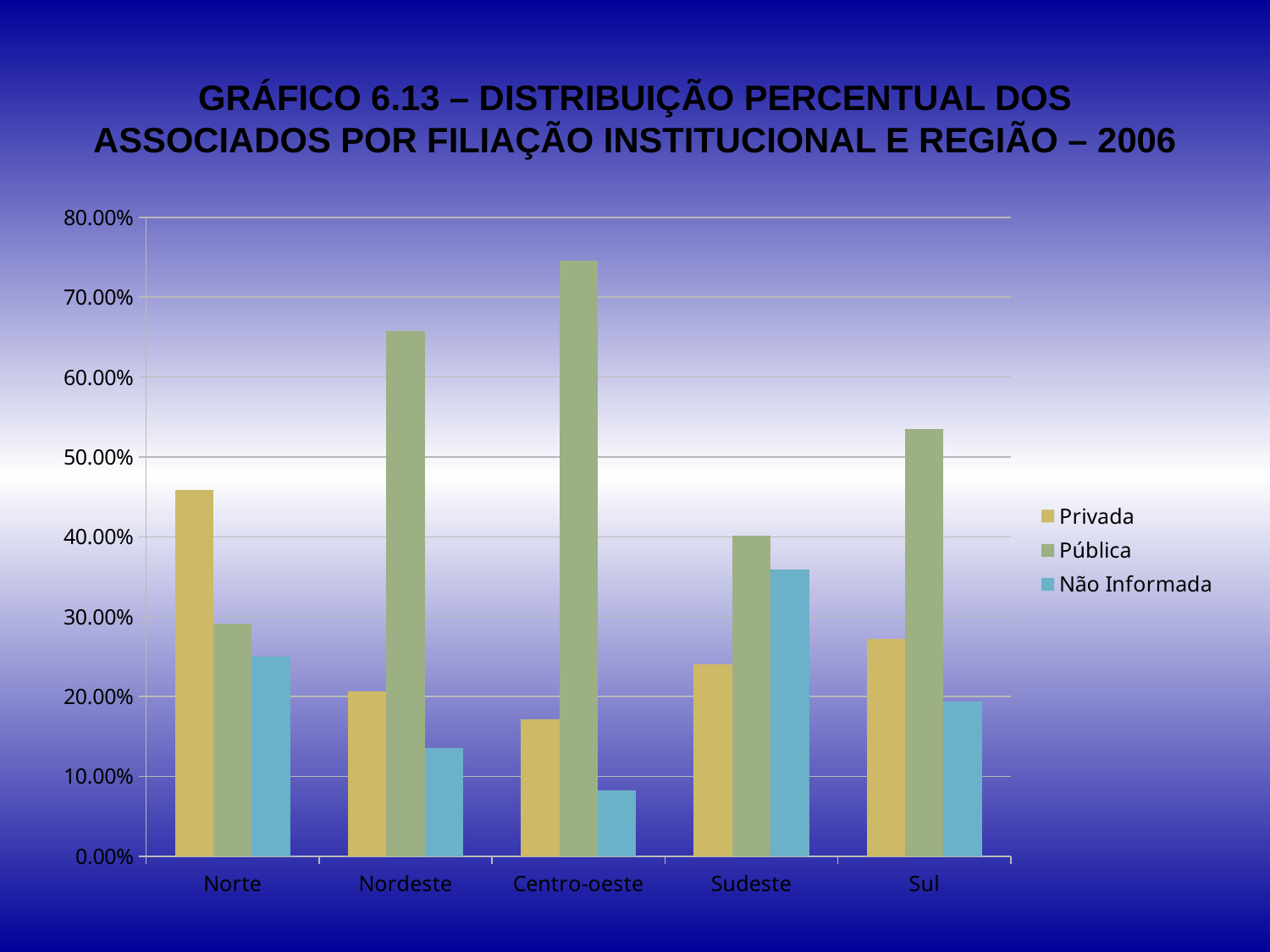
Which region has the highest value for Pública? Centro-oeste Is the value for Pública in Nordeste greater or less than 60.00%? greater Is the value for Privada in Norte greater or less than 40.00%? greater In Norte, which is larger: Privada or Pública? Privada Which year does the chart title refer to? 2006 Is the value for Não Informada in Centro-oeste greater or less than 10.00%? less Which region has the highest value for Privada? Norte Which region has the lowest value for Não Informada? Centro-oeste What kind of chart is shown on the slide? bar chart How many regions are shown on the x axis? 5 In Sul, which is larger: Privada or Não Informada? Privada How many series does the legend list? 3